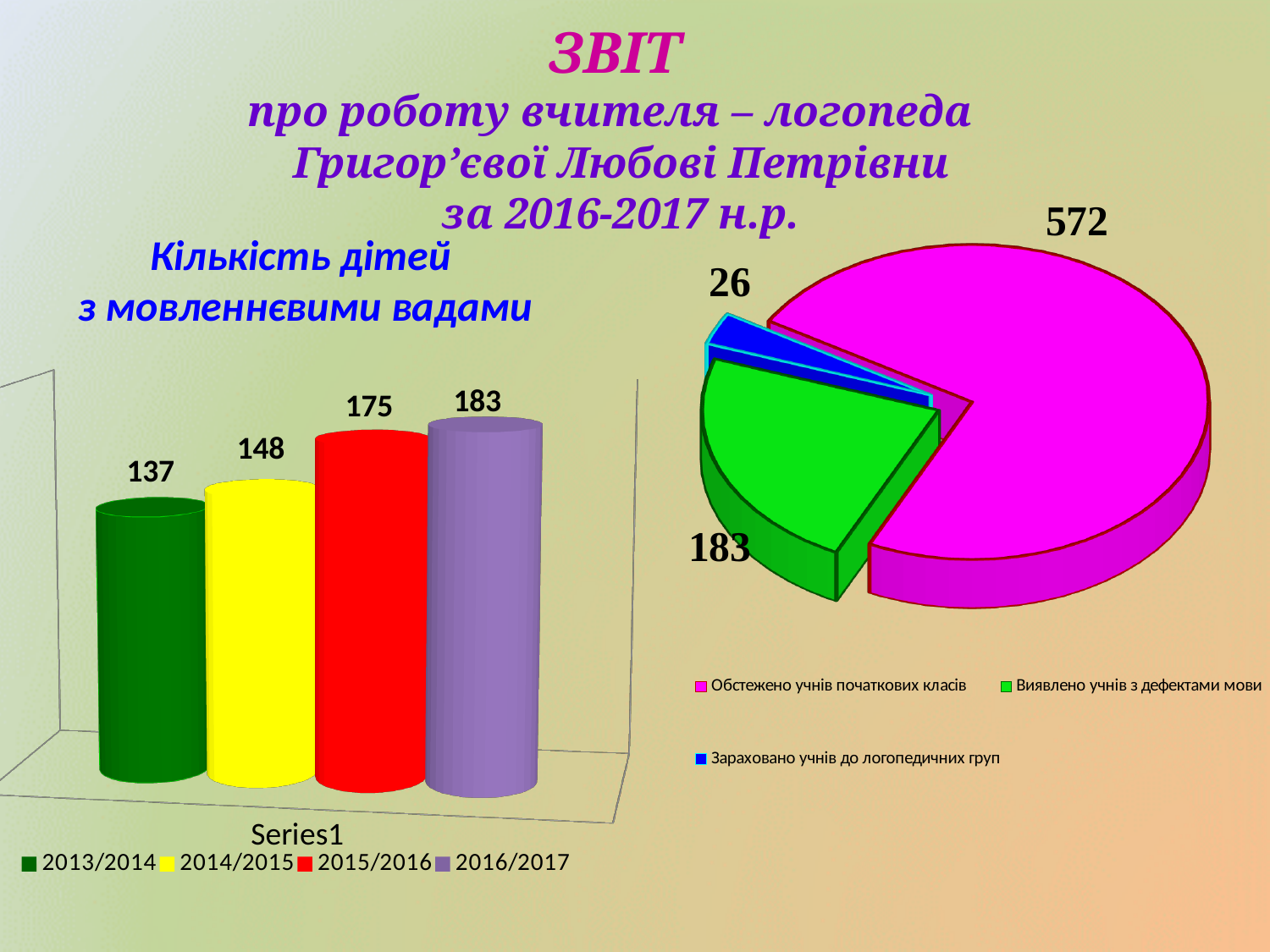
On the bar chart 'Кількість дітей з мовленнєвими вадами', do the values rise or fall from 2013/2014 to 2016/2017? rise On the pie chart on the right, what is the value for 'Зараховано учнів до логопедичних груп'? 26 On the bar chart 'Кількість дітей з мовленнєвими вадами', which is larger: the value for 2014/2015 or 2015/2016? 2015/2016 On the bar chart 'Кількість дітей з мовленнєвими вадами', which year has the lowest value? 2013/2014 On the bar chart 'Кількість дітей з мовленнєвими вадами', what is the value for 2013/2014? 137 On the pie chart on the right, what is the value for 'Обстежено учнів початкових класів'? 572 On the bar chart 'Кількість дітей з мовленнєвими вадами', what is the difference between the values for 2016/2017 and 2013/2014? 46 On the pie chart on the right, what is the difference between 'Обстежено учнів початкових класів' and 'Виявлено учнів з дефектами мови'? 389 What kind of chart is the chart on the left of the slide? bar chart On the bar chart 'Кількість дітей з мовленнєвими вадами', what is the value for 2015/2016? 175 On the bar chart 'Кількість дітей з мовленнєвими вадами', how many bars are shown? 4 On the bar chart 'Кількість дітей з мовленнєвими вадами', which year has the highest value? 2016/2017